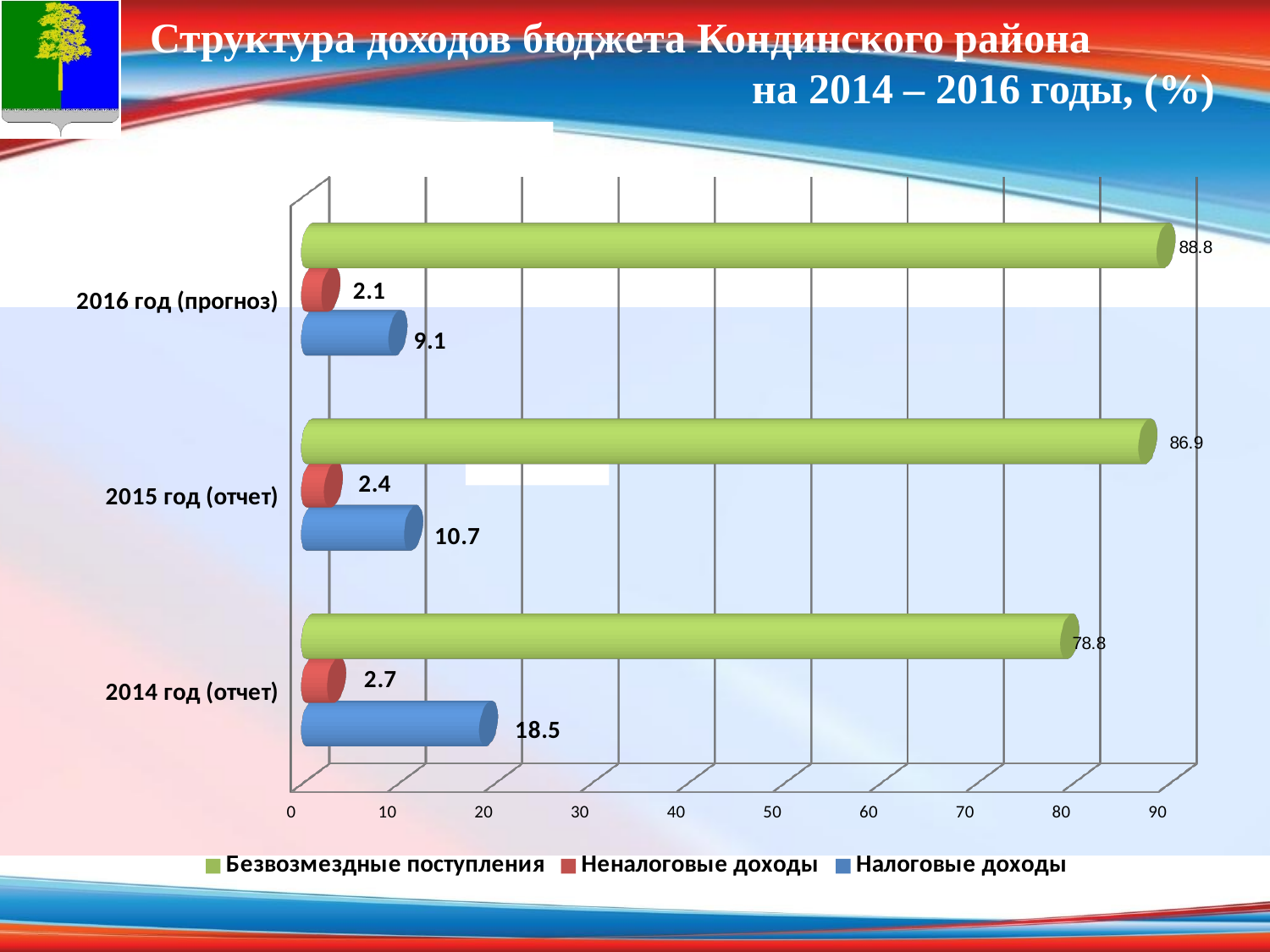
What kind of chart is shown on the slide? bar chart What is the difference between Безвозмездные поступления in 2016 год (прогноз) and 2014 год (отчет)? 10 Which year has the highest value for Налоговые доходы? 2014 год (отчет) What is the value of Налоговые доходы for 2014 год (отчет)? 18.5 What is the value of Неналоговые доходы for 2015 год (отчет)? 2.4 Which is larger: Налоговые доходы in 2015 год (отчет) or in 2016 год (прогноз)? 2015 год (отчет) What is the value of Безвозмездные поступления for 2016 год (прогноз)? 88.8 Which colour represents Неналоговые доходы in the legend? red Which year has the lowest value for Безвозмездные поступления? 2014 год (отчет) How many series does the legend list? 3 Is the value of Безвозмездные поступления for 2015 год (отчет) greater or less than 80? greater How many year categories are shown on the chart? 3